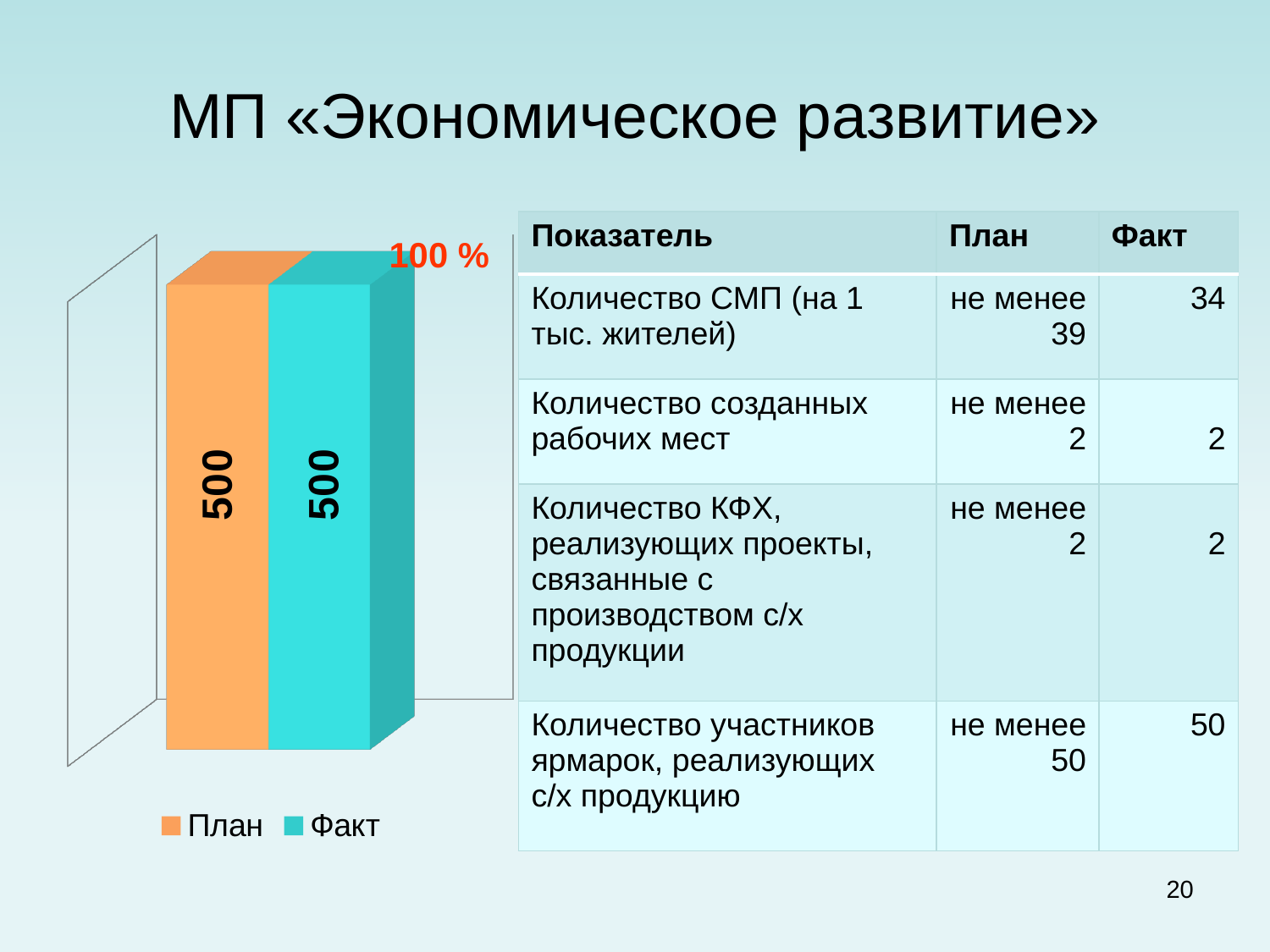
What kind of chart is shown on the slide? bar chart What is the difference between the План and Факт values in the chart? 0 How many bars are plotted in the chart? 2 What percentage label is shown above the bars in the chart? 100 % What is the value of the План bar in the chart? 500 Which legend entry is shown in orange in the chart? План How many series does the chart legend list? 2 Are the План and Факт values in the chart equal? Yes What is the value of the Факт bar in the chart? 500 What is the total of the План and Факт values shown in the chart? 1000